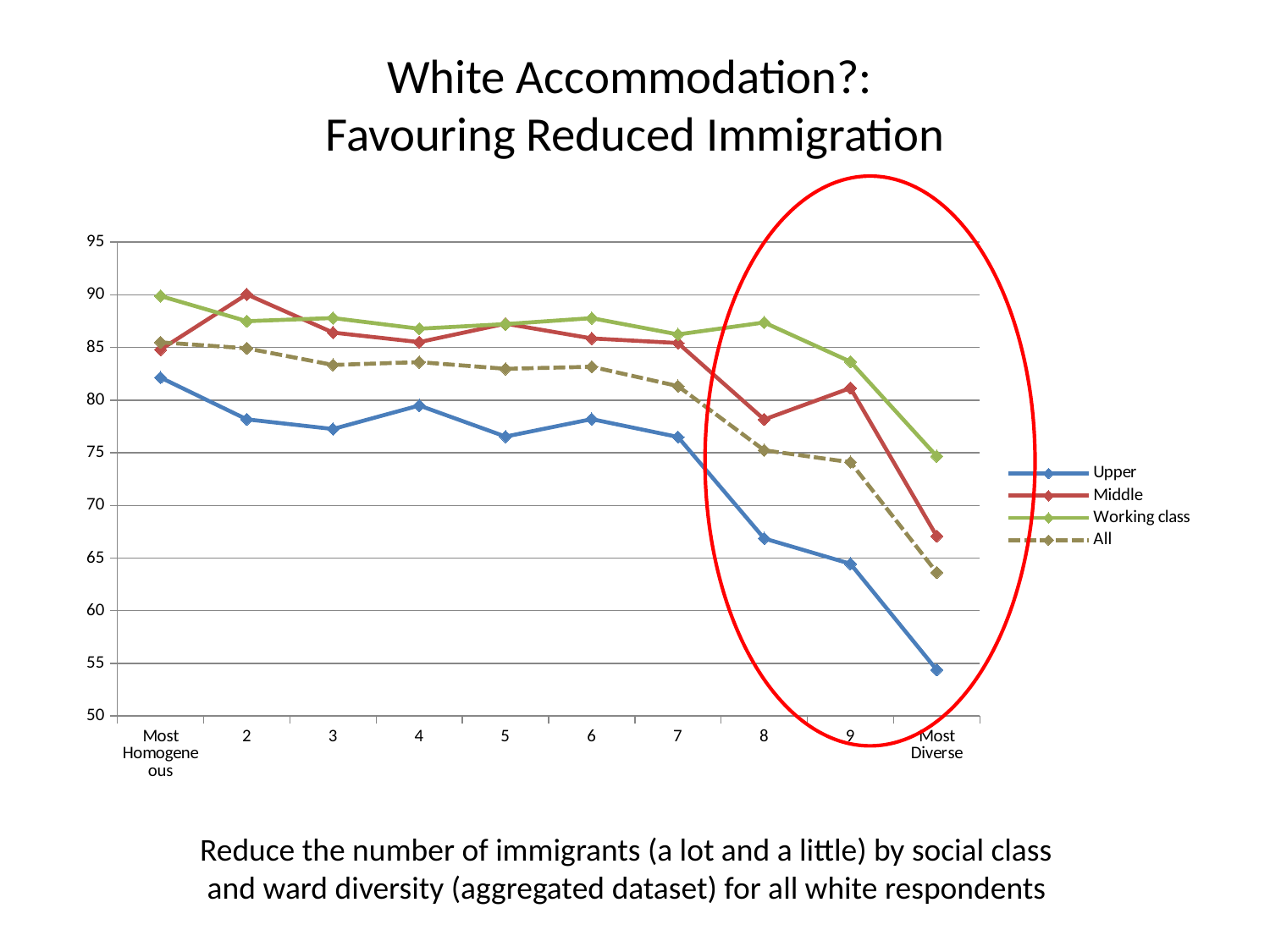
Which series has the lowest value at Most Diverse? Upper Is the value for All at Most Diverse greater or less than 65? less How many series does the legend list? 4 What kind of chart is shown on the slide? line chart Is the value for Upper at Most Diverse greater or less than 60? less Does the Upper series rise or fall overall from Most Homogeneous to Most Diverse? fall Is the value for Working class at Most Homogeneous greater or less than 85? greater At Most Diverse, which is larger: Middle or Upper? Middle Which series is drawn with a dashed line? All How many categories are shown along the x axis? 10 Which series has the highest value at Most Diverse? Working class